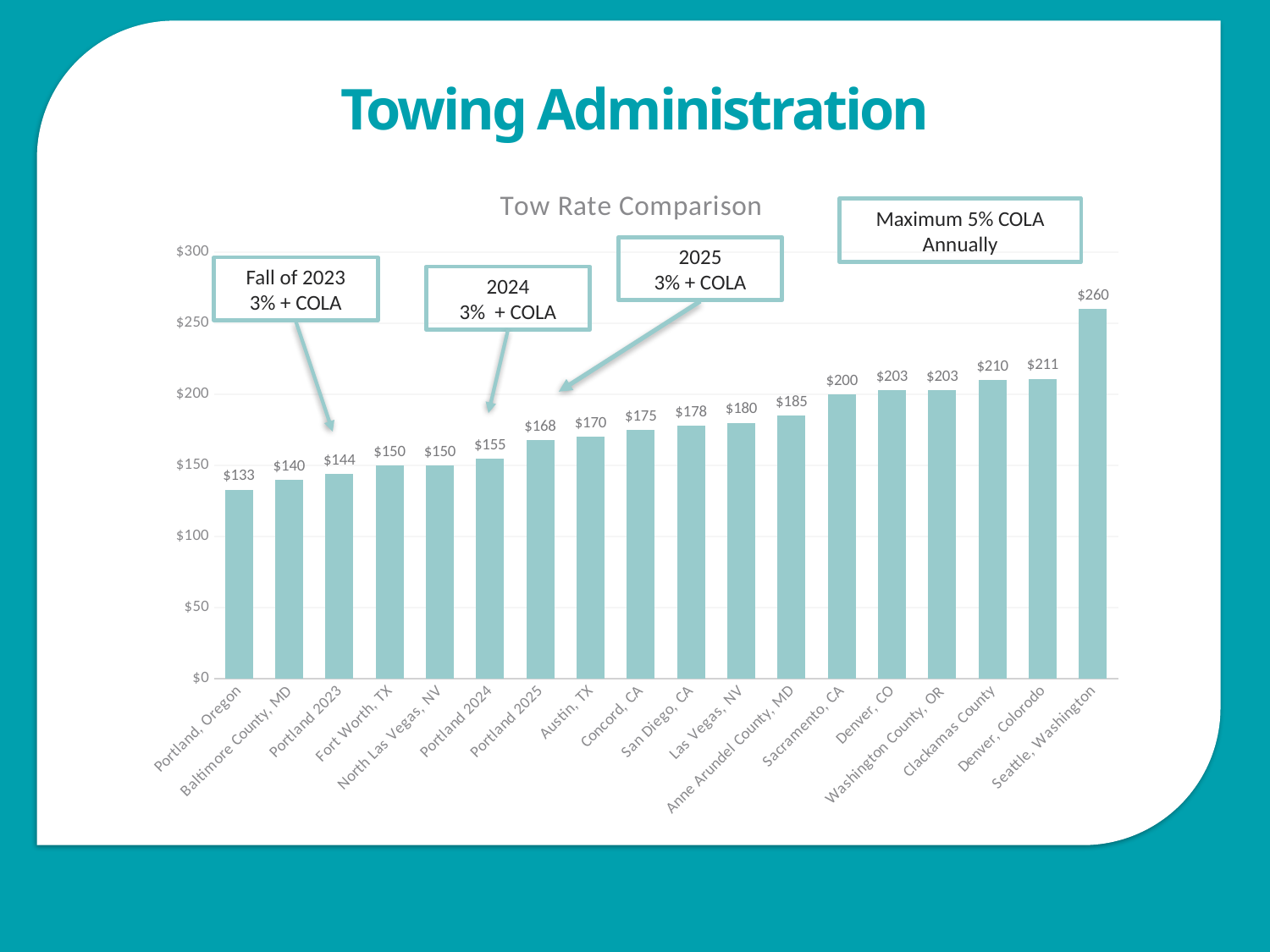
What is the tow rate shown for Portland 2025? $168 How many categories are shown on the x axis of the chart? 18 What is the tow rate shown for Seattle, Washington? $260 Which category has the highest tow rate? Seattle, Washington What is the title of the chart? Tow Rate Comparison Which has a higher tow rate, Austin, TX or Sacramento, CA? Sacramento, CA What is the difference between the tow rates for Seattle, Washington and Portland, Oregon? $127 What is the tow rate shown for Anne Arundel County, MD? $185 What is the difference between the tow rates for Portland 2025 and Portland 2023? $24 Which category has the lowest tow rate? Portland, Oregon What is the tow rate shown for Portland, Oregon? $133 What kind of chart is shown on the slide? Bar chart